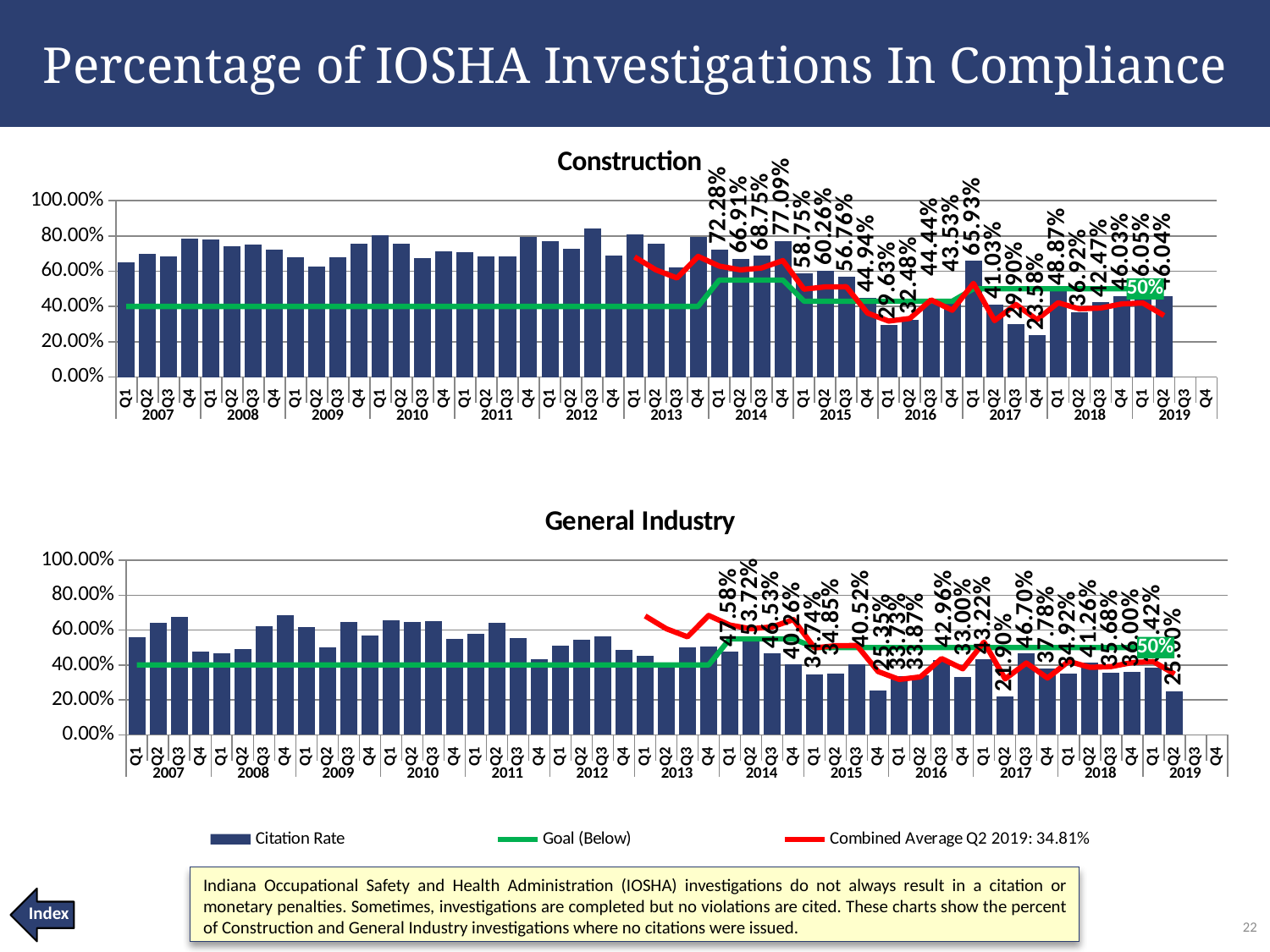
In the Construction chart, what is the difference between the citation rates for Q4 2014 and Q4 2017? 53.51 percentage points In the General Industry chart, is the citation rate for Q4 2012 greater or less than 60%? less In the Construction chart, which quarter has the higher citation rate, Q1 2014 or Q1 2016? Q1 2014 In the Construction chart, what is the citation rate for Q4 2017? 23.58% What value is labeled on the green Goal line in both charts? 50% In the Construction chart, what is the citation rate for Q4 2014? 77.09% What kind of chart is the Construction chart? bar chart with line overlays How many series does the legend list for the charts? 3 In the General Industry chart, what is the citation rate for Q2 2017? 21.90% According to the legend, what is the Combined Average for Q2 2019? 34.81% In the Construction chart, which quarter has the highest labeled citation rate among the values printed from 2014 onward? Q4 2014 In the General Industry chart, what is the citation rate for Q2 2019? 25.00%